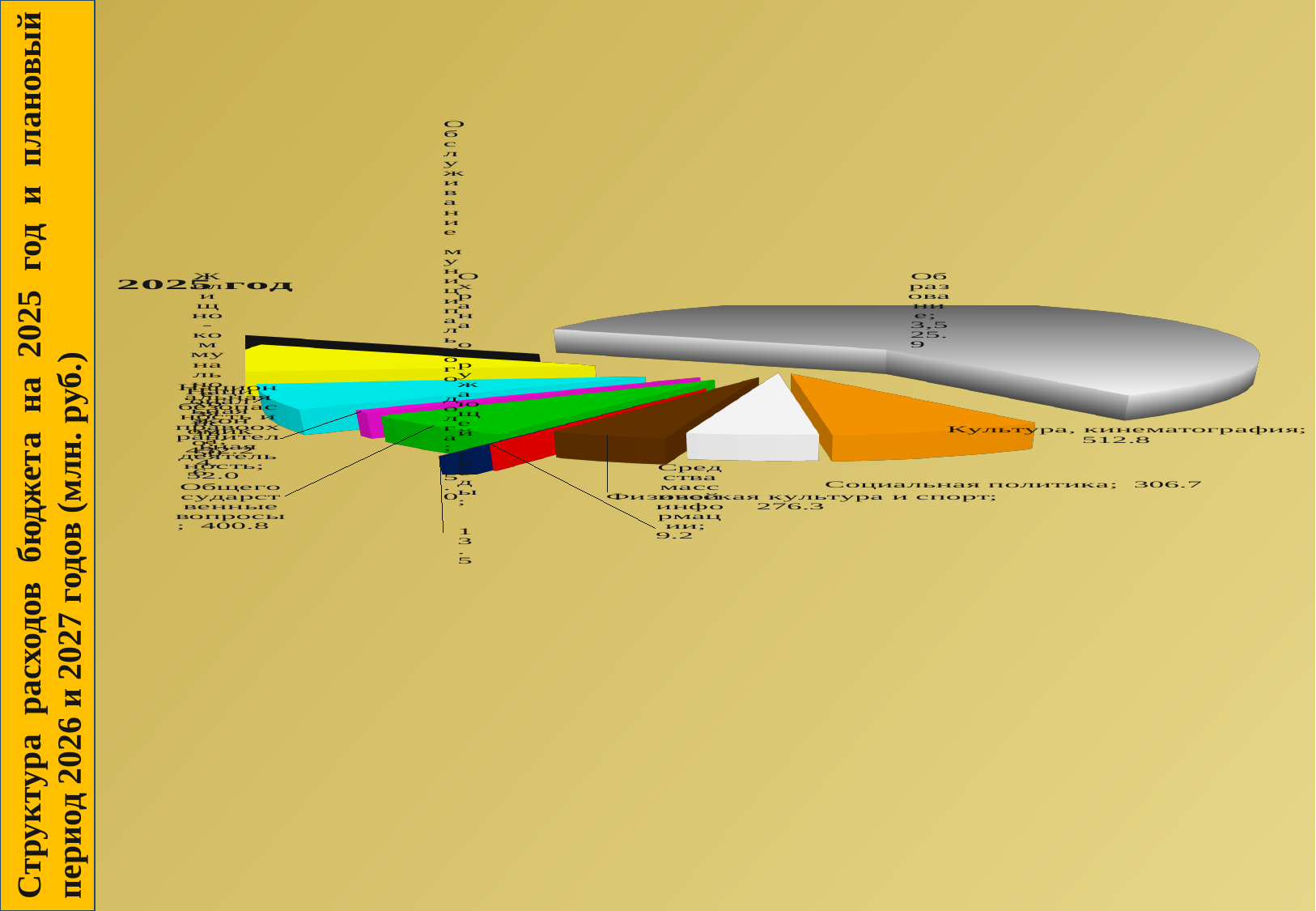
Which is larger, Социальная политика or Физическая культура и спорт? Социальная политика What is the value for Социальная политика? 306.7 What is the difference between Культура, кинематография and Социальная политика? 206.1 Which is larger, Культура, кинематография or Социальная политика? Культура, кинематография What is the value for Средства массовой информации? 9.2 What kind of chart is shown on the slide? pie chart What year is shown in the chart title? 2025 год What is the value for Физическая культура и спорт? 276.3 What is the difference between Общегосударственные вопросы and Физическая культура и спорт? 124.5 What is the value for Культура, кинематография? 512.8 Which category has the largest slice of the pie? Образование What is the value for Общегосударственные вопросы? 400.8